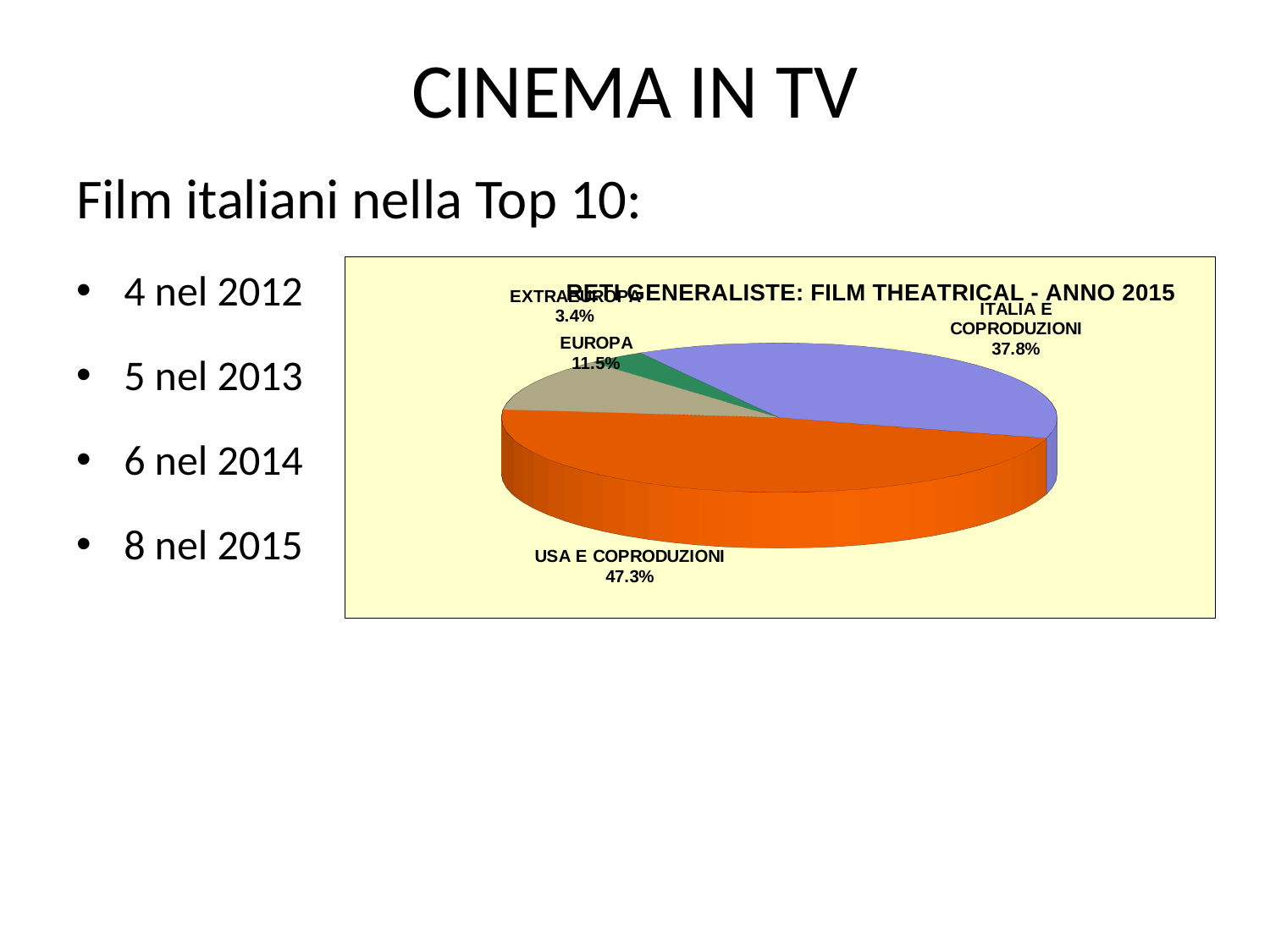
What share of the pie does EUROPA have? 11.5% Which is larger, the share for EUROPA or the share for EXTRAEUROPA? EUROPA What share of the pie does USA E COPRODUZIONI have? 47.3% What kind of chart is shown on the slide? Pie chart Which category has the smallest slice of the pie? EXTRAEUROPA What is the title of the chart? RETI GENERALISTE: FILM THEATRICAL - ANNO 2015 How many slices does the pie chart have? 4 What share of the pie does ITALIA E COPRODUZIONI have? 37.8% What is the difference in percentage points between USA E COPRODUZIONI and ITALIA E COPRODUZIONI? 9.5 What colour is the USA E COPRODUZIONI slice? Orange Which category has the largest slice of the pie? USA E COPRODUZIONI